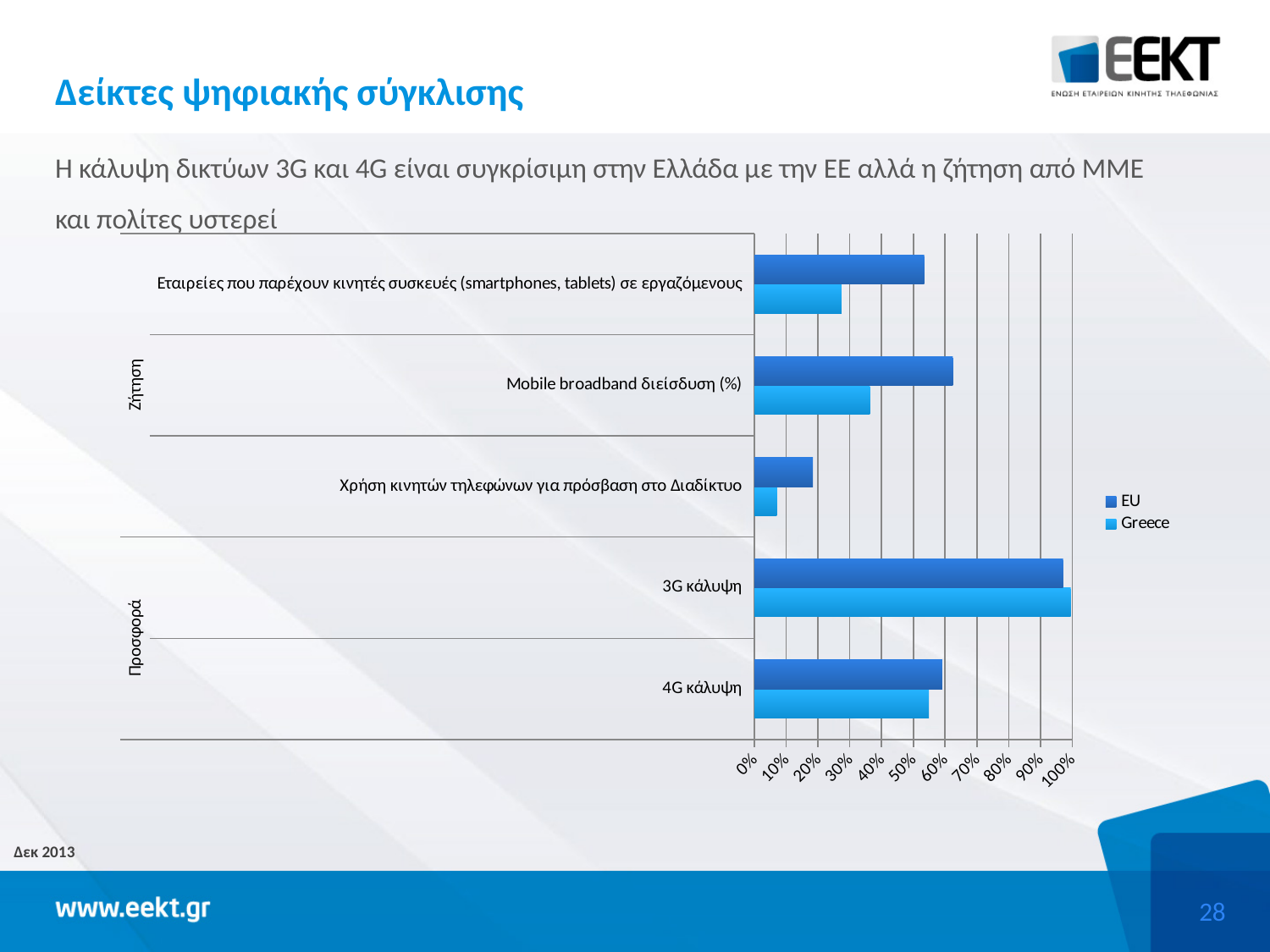
Which series is shown in the lighter blue colour in the legend? Greece Which category has the lowest value for the EU series? Χρήση κινητών τηλεφώνων για πρόσβαση στο Διαδίκτυο For Εταιρείες που παρέχουν κινητές συσκευές (smartphones, tablets) σε εργαζόμενους, which series has the larger value, EU or Greece? EU Is the Greece value for Χρήση κινητών τηλεφώνων για πρόσβαση στο Διαδίκτυο greater or less than 10%? less Is the EU value for Mobile broadband διείσδυση (%) greater or less than 50%? greater How many categories are plotted in the chart? 5 Which category has the lowest value for the Greece series? Χρήση κινητών τηλεφώνων για πρόσβαση στο Διαδίκτυο For Mobile broadband διείσδυση (%), which series has the larger value, EU or Greece? EU What kind of chart is shown on the slide? bar chart Which category has the highest value for the EU series? 3G κάλυψη How many series does the legend list? 2 Which category has the highest value for the Greece series? 3G κάλυψη